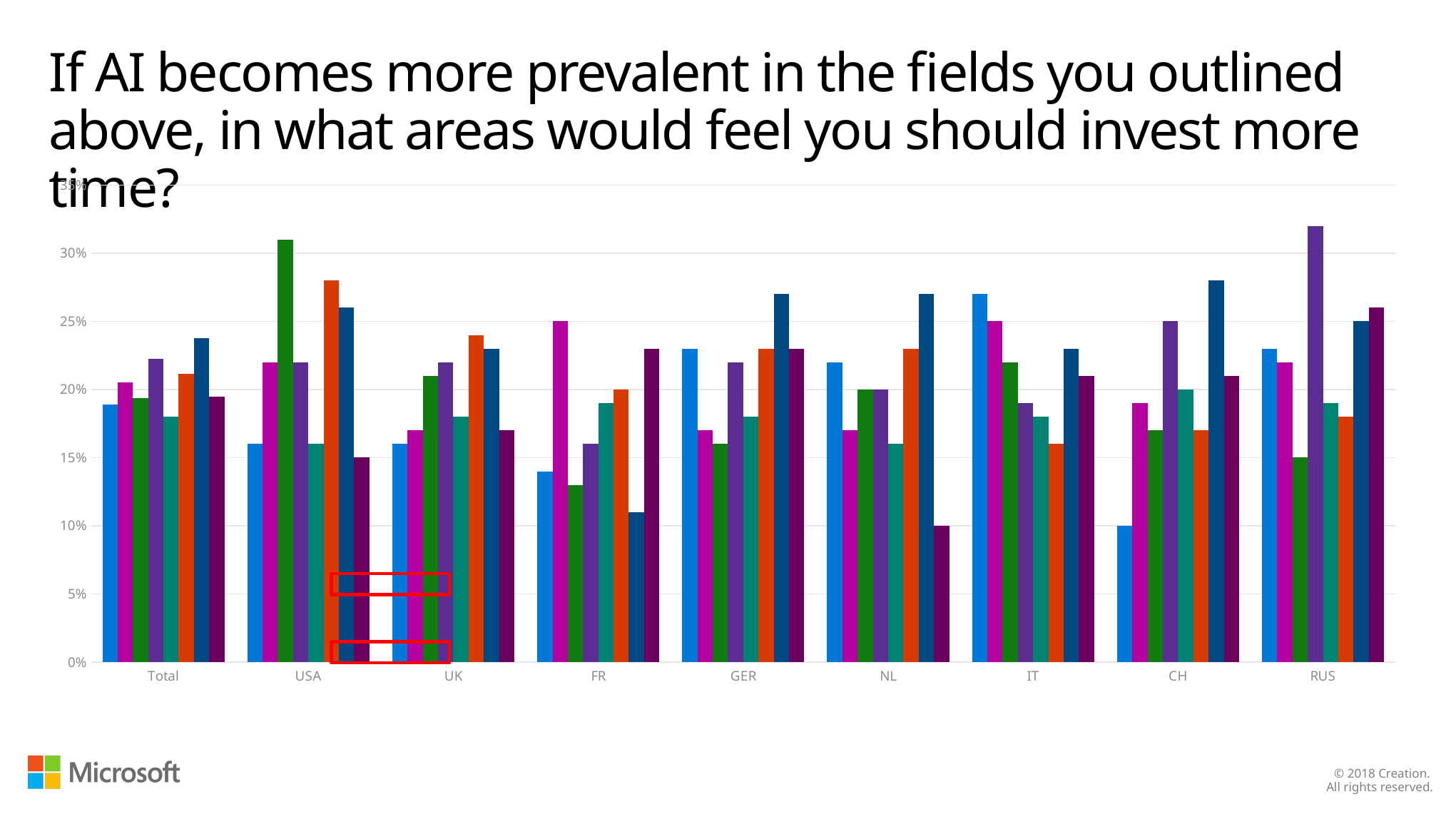
Is the value of the green bar for USA greater or less than 25%? greater Is the value of the magenta bar for FR greater or less than 20%? greater Which category is plotted furthest to the right on the x axis? RUS Is the value of the purple bar for RUS greater or less than 30%? greater How many categories are shown along the x axis of the chart? 9 For USA, which is larger: the green bar or the light blue bar? the green bar What kind of chart is shown on the slide? bar chart For RUS, which coloured bar is the tallest? the purple bar